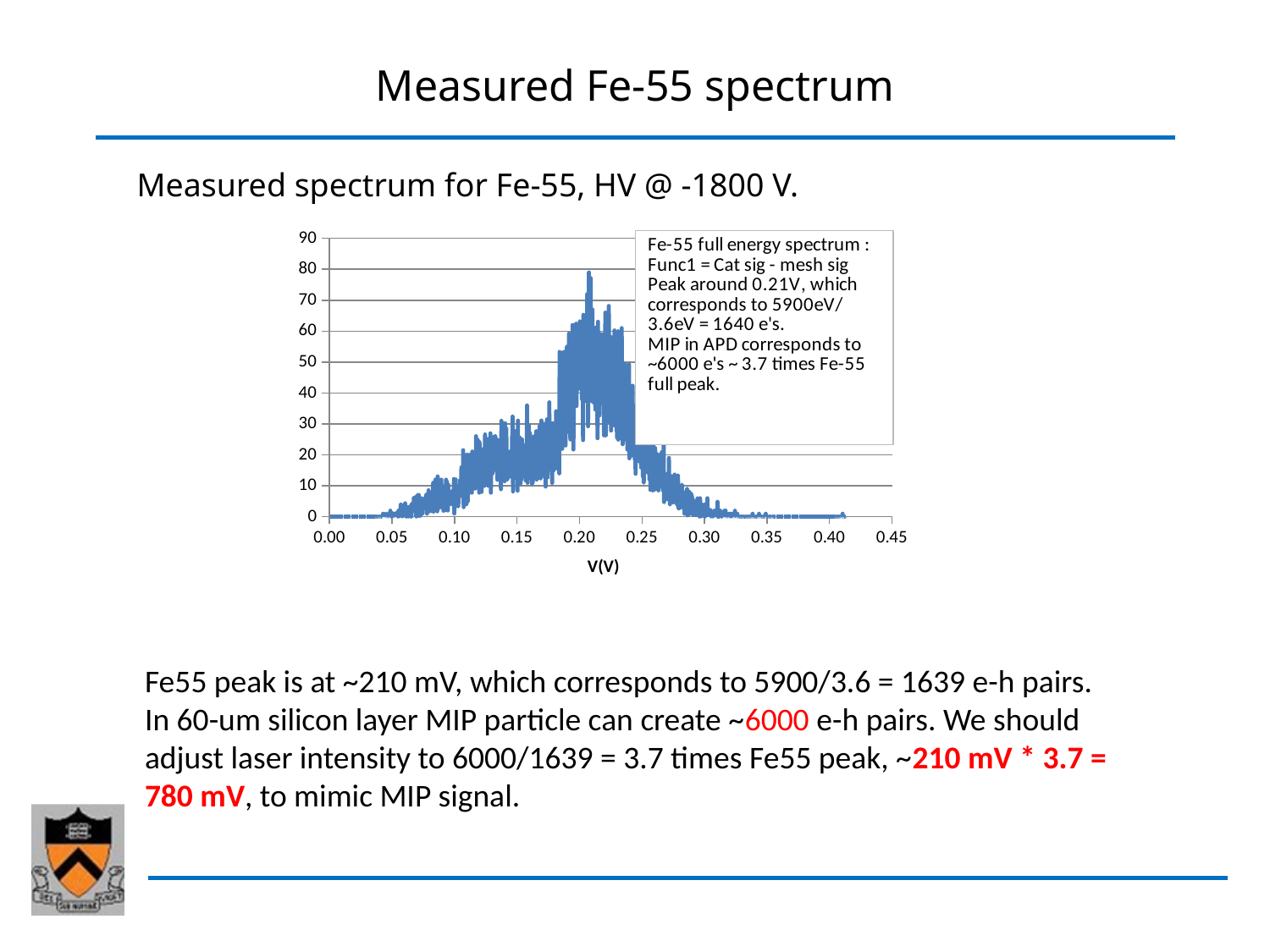
Do the values generally rise or fall along the x axis between 0.05 V and 0.20 V? rise What is the largest tick value shown on the x axis of the chart? 0.45 Around which x-axis value does the spectrum reach its peak? 0.21 V What is the label of the x axis of the chart? V(V) Is the value of the spectrum at 0.10 V greater or less than 40? less Is the peak value of the spectrum greater or less than 70? greater Is the value of the spectrum at 0.35 V greater or less than 10? less What kind of chart is shown on the slide? line chart What is the highest value shown on the y axis of the chart? 90 Do the values generally rise or fall along the x axis between 0.25 V and 0.35 V? fall